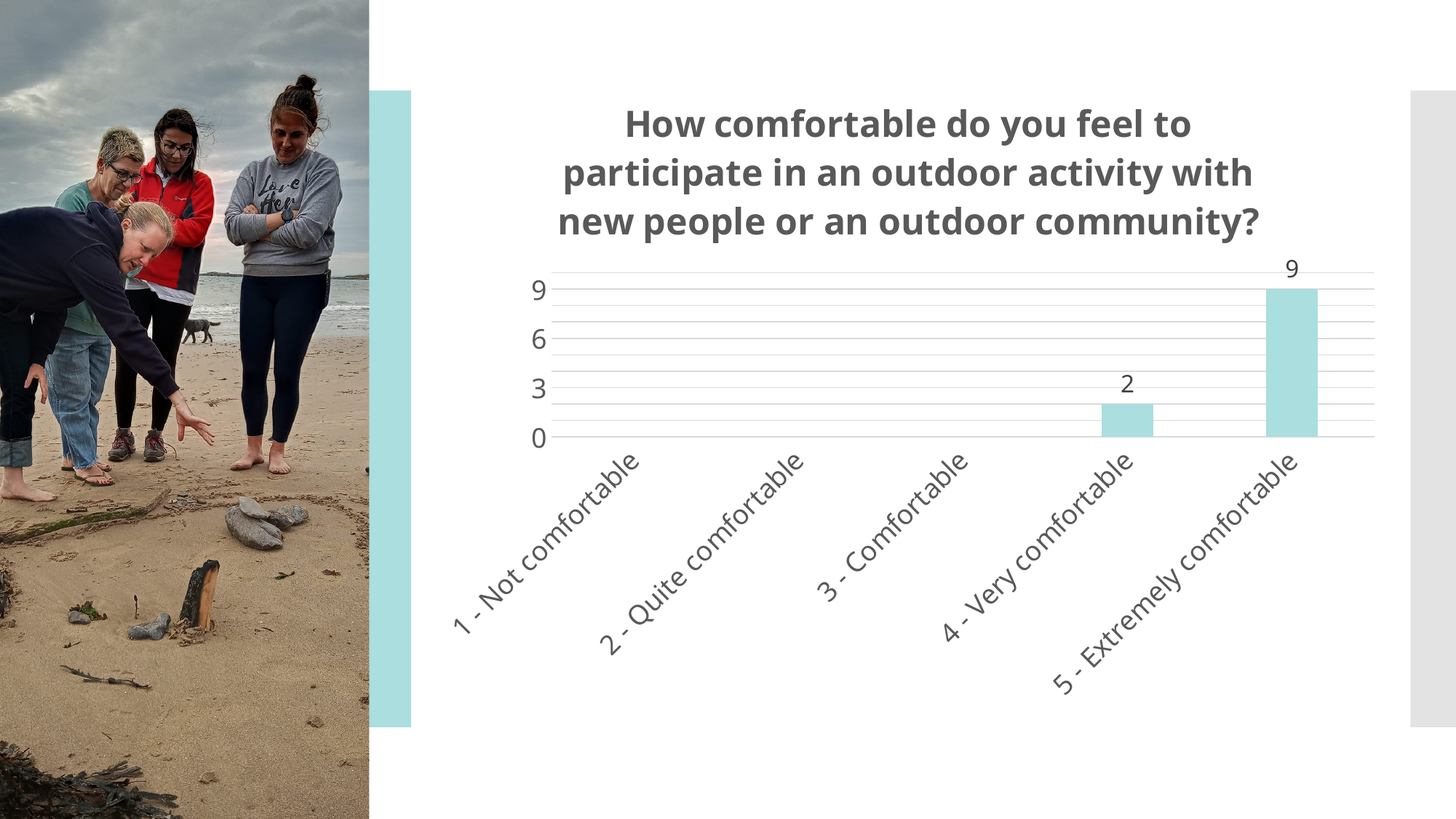
What kind of chart is shown on the slide? bar chart What is the title of the chart? How comfortable do you feel to participate in an outdoor activity with new people or an outdoor community? Is the value for "4 - Very comfortable" greater or less than 3? less How many categories are shown on the x axis? 5 Which category has the highest value? 5 - Extremely comfortable What is the difference between the values for "5 - Extremely comfortable" and "4 - Very comfortable"? 7 What is the highest value shown on the y axis? 9 How many categories have a visible bar? 2 Is the value for "5 - Extremely comfortable" greater or less than 6? greater What is the value for "4 - Very comfortable"? 2 Which is larger, the value for "4 - Very comfortable" or the value for "5 - Extremely comfortable"? 5 - Extremely comfortable What is the value for "5 - Extremely comfortable"? 9